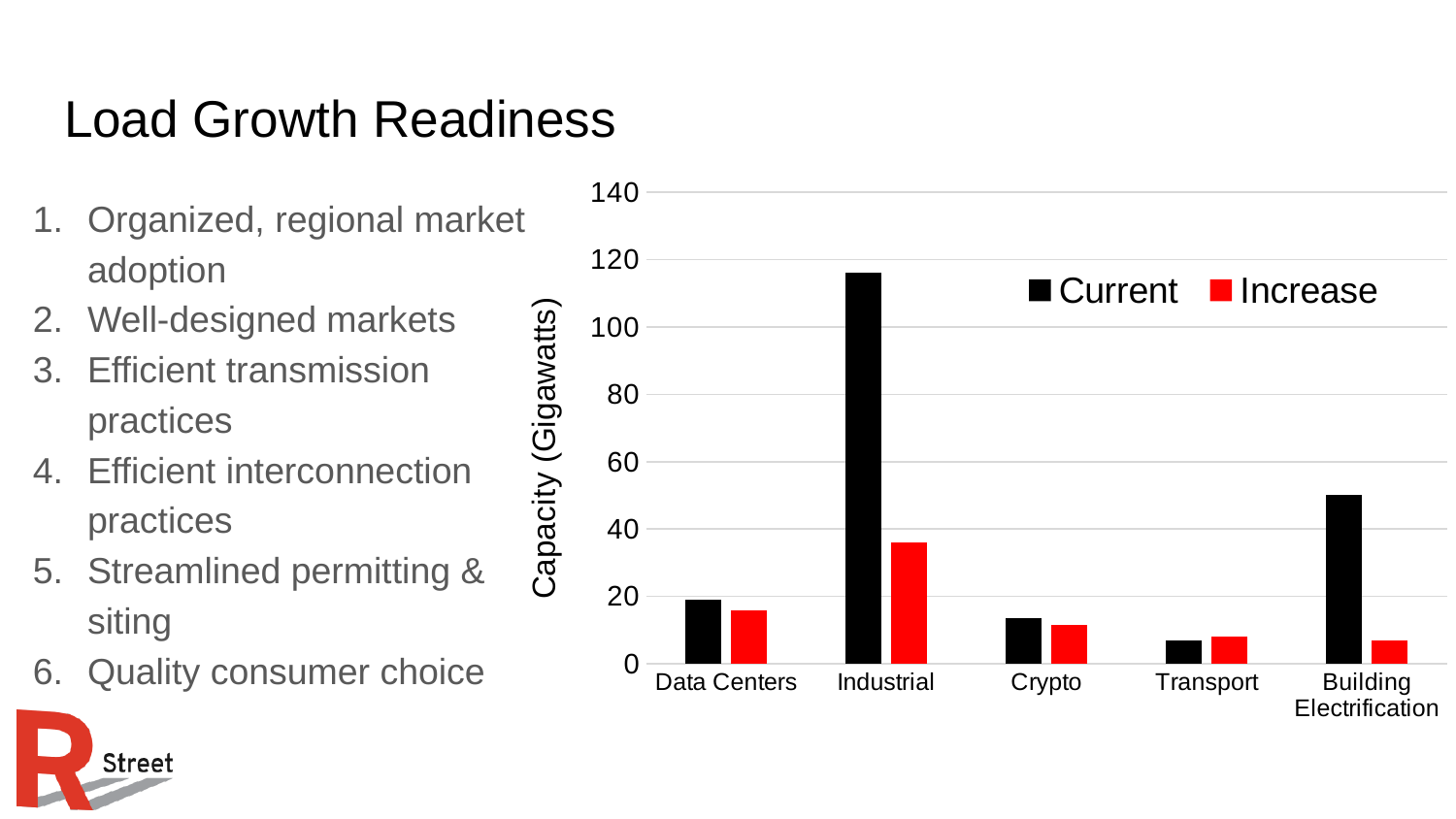
Which category has the highest Increase value? Industrial Which is larger, the Current value for Data Centers or the Current value for Crypto? Data Centers Is the Current value for Industrial greater or less than 100? greater What is the label on the vertical axis of the chart? Capacity (Gigawatts) Is the Current value for Crypto greater or less than 20? less Is the Current value for Building Electrification greater or less than 40? greater Which category has the highest Current value? Industrial What kind of chart is shown on the slide? bar chart How many series does the chart legend list? 2 Which category has the lowest Current value? Transport How many categories are shown on the x axis of the chart? 5 For Building Electrification, which is larger, the Current value or the Increase value? Current